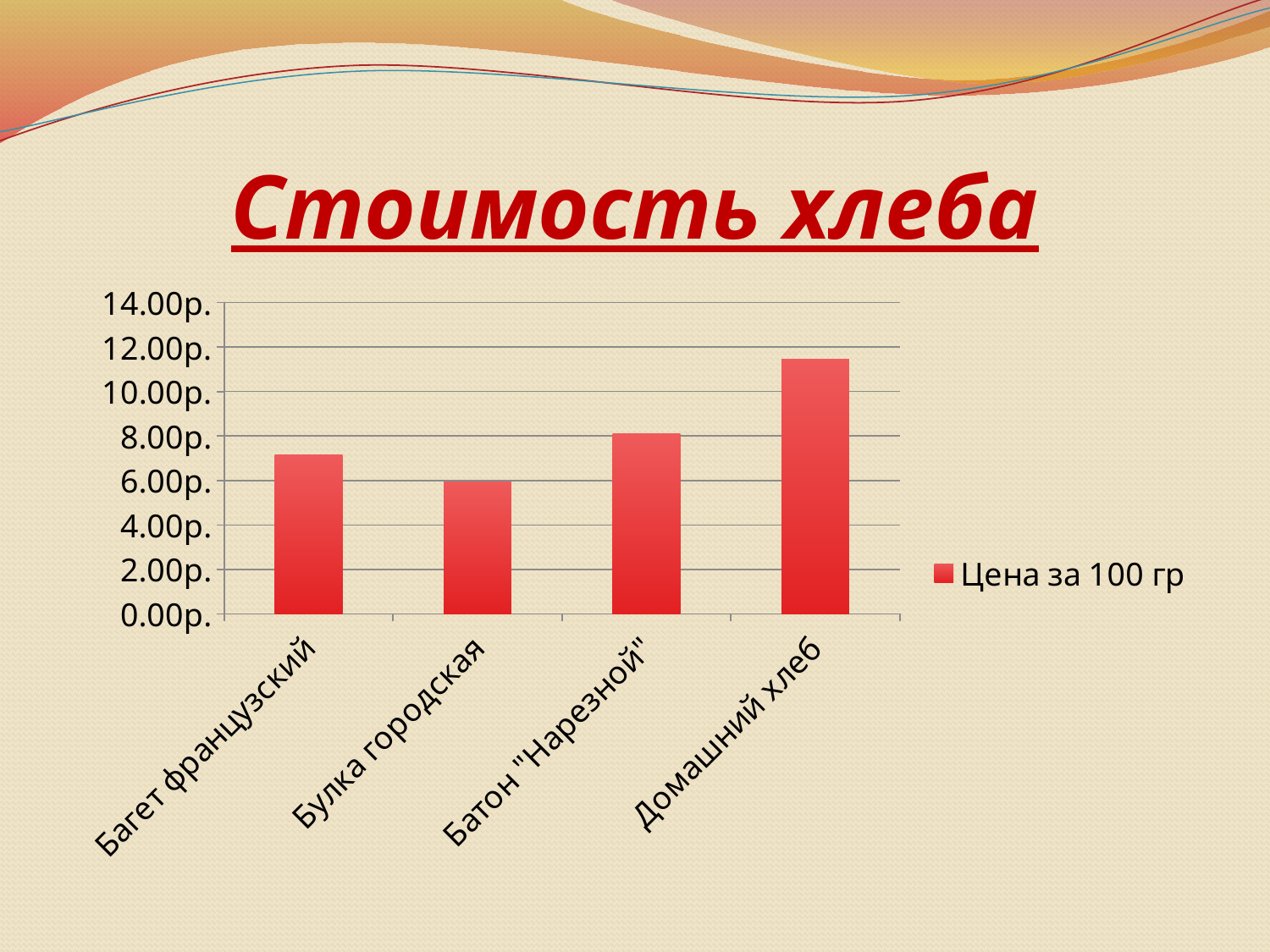
What is the title of the chart on the slide? Стоимость хлеба What is the name of the series shown in the chart's legend? Цена за 100 гр How many series does the chart's legend list? 1 Is the value for Домашний хлеб greater or less than 10.00р.? greater Which is priced higher per 100 g: Домашний хлеб or Булка городская? Домашний хлеб How many categories of bread are shown on the x axis of the chart? 4 Which bread has the highest price per 100 g in the chart? Домашний хлеб Is the value for Багет французский greater or less than 8.00р.? less What kind of chart is shown on the slide? bar chart Is the value for Батон "Нарезной" greater or less than 10.00р.? less Which bread has the lowest price per 100 g in the chart? Булка городская Which is priced higher per 100 g: Батон "Нарезной" or Багет французский? Батон "Нарезной"